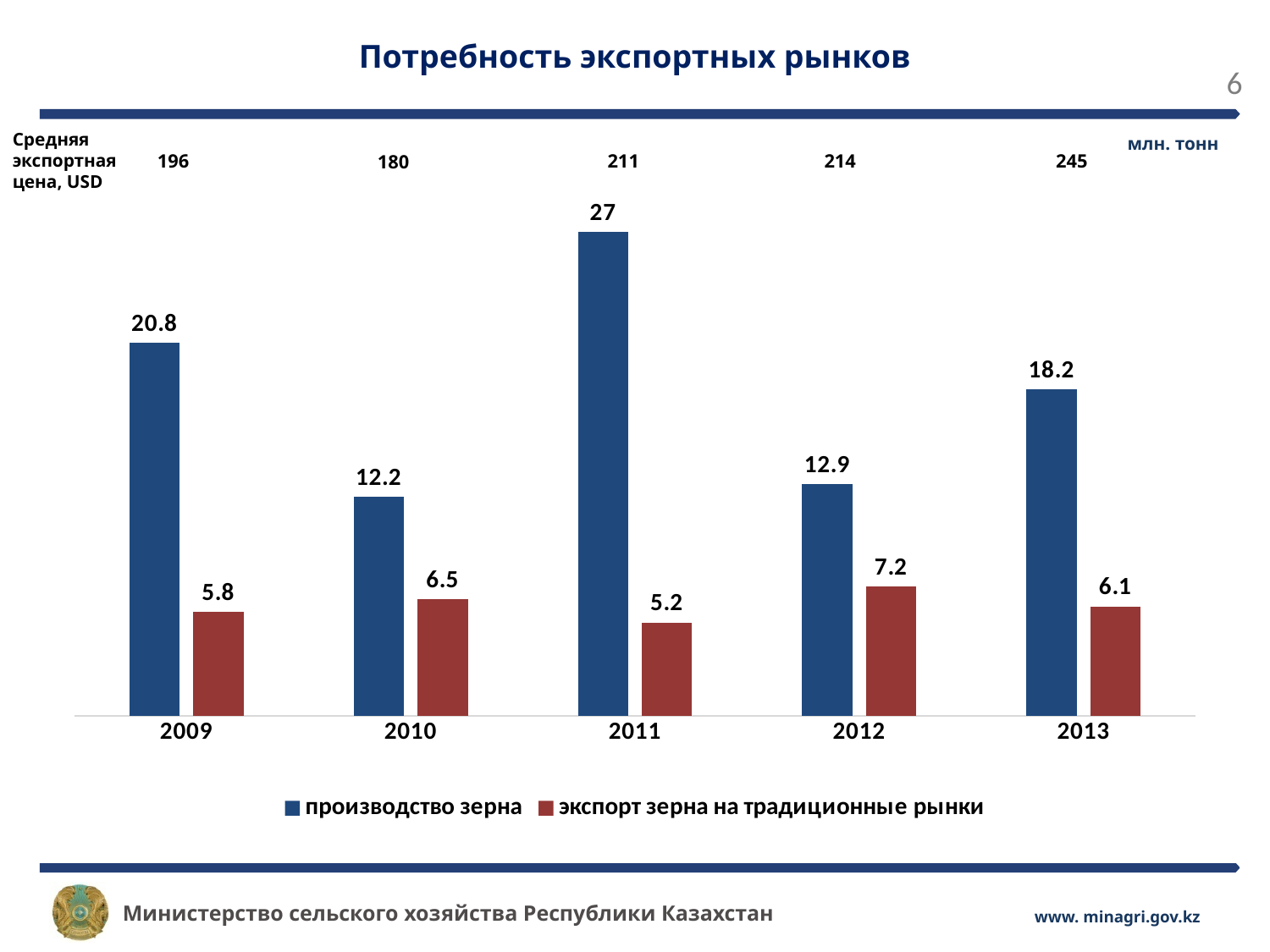
Which is larger: экспорт зерна на традиционные рынки in 2010 or in 2013? 2010 What is the value of производство зерна for 2013? 18.2 Which year has the highest value for производство зерна? 2011 Which year has the lowest value for экспорт зерна на традиционные рынки? 2011 How many years are shown on the x axis? 5 What is the value of производство зерна for 2011? 27 What kind of chart is shown on the slide? bar chart What is the difference between производство зерна and экспорт зерна на традиционные рынки in 2009? 15 What is the title of the chart? Потребность экспортных рынков What is the average export price (Средняя экспортная цена, USD) shown above the 2013 bars? 245 What is the value of экспорт зерна на традиционные рынки for 2012? 7.2 How many series does the legend list? 2